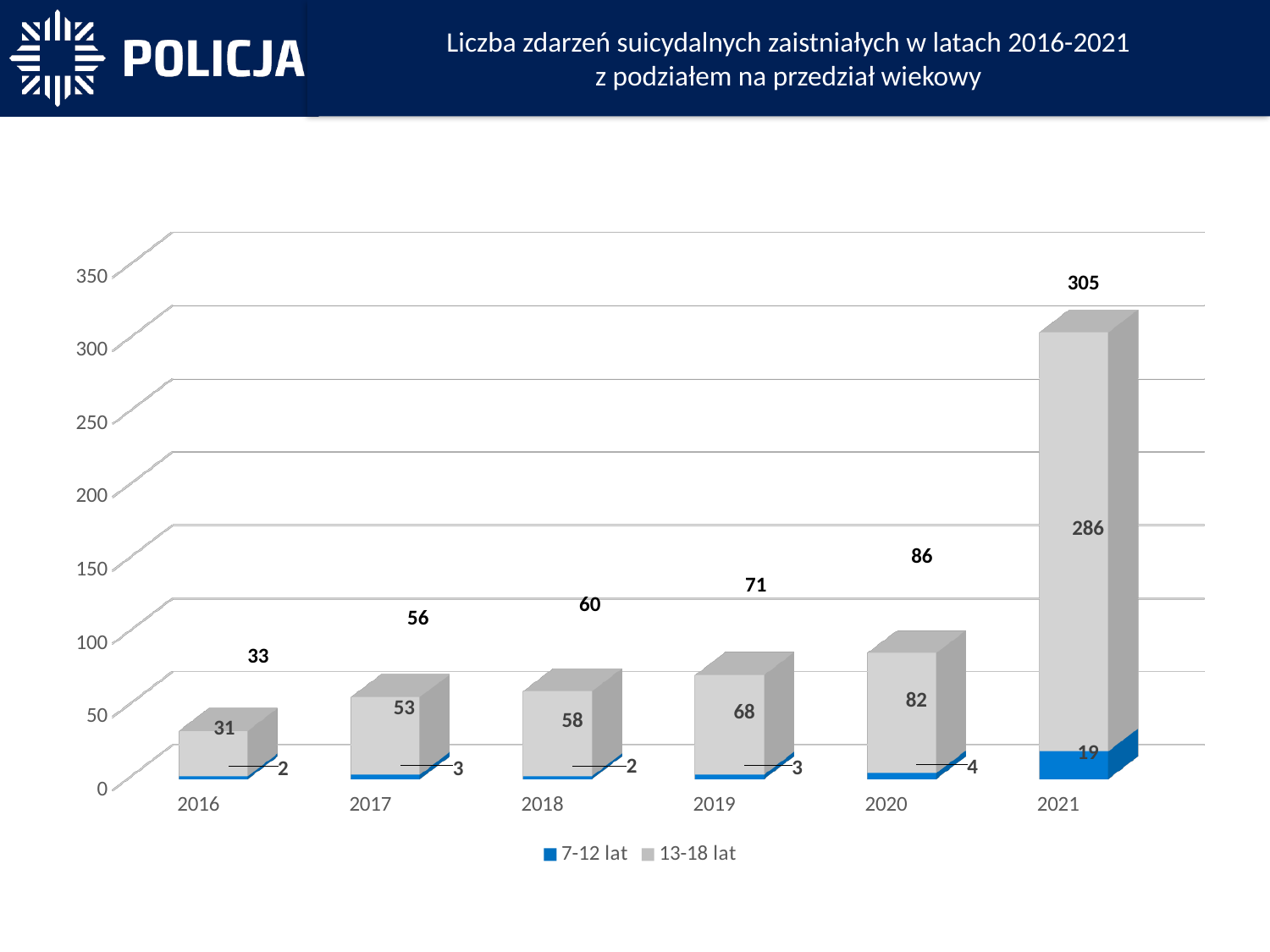
How many series does the legend list? 2 Which is larger, the 7-12 lat value in 2021 or in 2017? 2021 What is the total of the stacked bar for 2019? 71 Do the total values rise or fall from 2016 to 2021? rise What kind of chart is shown on the slide? stacked bar chart Is the total for 2020 greater or less than 100? less What is the difference between the 13-18 lat values for 2021 and 2020? 204 Which year has the highest total number of events? 2021 Which year has the lowest total number of events? 2016 What is the value for the 7-12 lat series in 2020? 4 What is the value for the 13-18 lat series in 2021? 286 How many years are shown on the x axis? 6